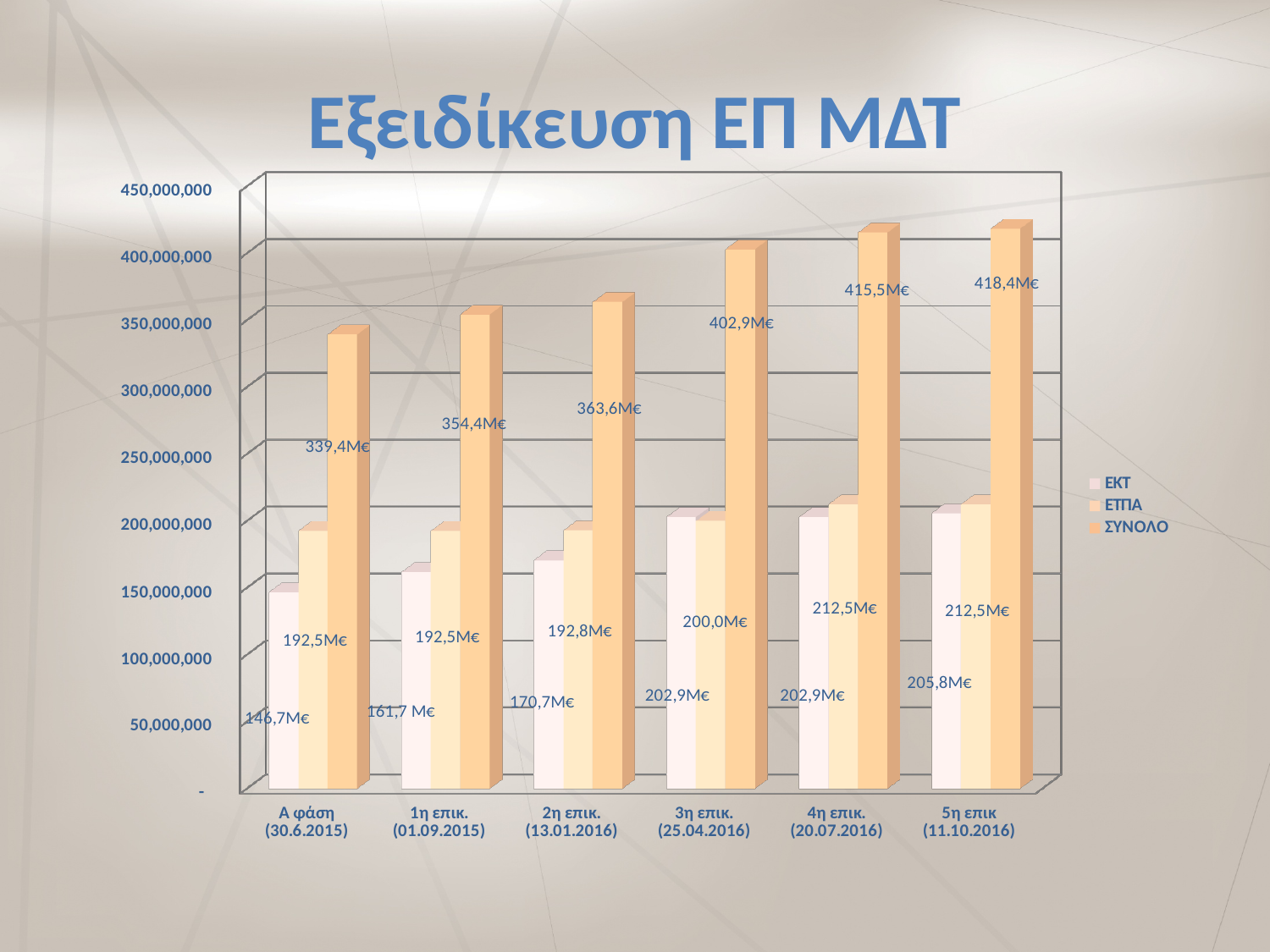
What is the ΕΤΠΑ value for 5η επικ (11.10.2016)? 212,5M€ What is the difference between the ΕΤΠΑ values for 4η επικ. (20.07.2016) and 3η επικ. (25.04.2016)? 12,5M€ Which is larger for 1η επικ. (01.09.2015): the ΕΚΤ value or the ΕΤΠΑ value? ΕΤΠΑ What is the ΣΥΝΟΛΟ value for 3η επικ. (25.04.2016)? 402,9M€ What kind of chart is shown on the slide? Bar chart Which category has the lowest ΕΚΤ value? Α φάση (30.6.2015) How many series does the legend list? 3 Do the ΣΥΝΟΛΟ values rise or fall from Α φάση to 5η επικ? Rise What is the ΕΚΤ value for Α φάση (30.6.2015)? 146,7M€ Which category has the highest ΣΥΝΟΛΟ value? 5η επικ (11.10.2016) How many categories are shown on the x axis? 6 What is the ΕΚΤ value for 2η επικ. (13.01.2016)? 170,7M€